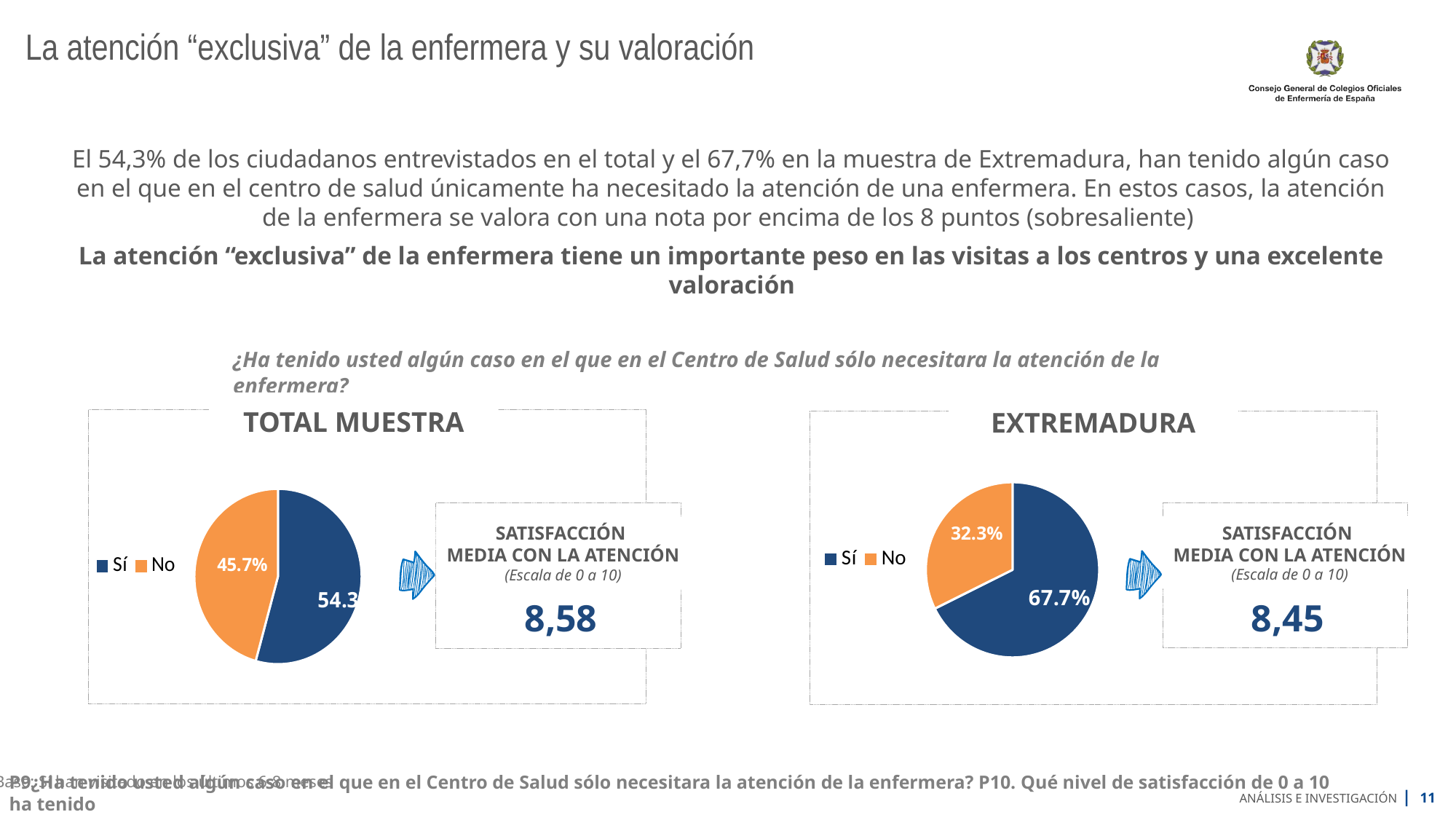
In the EXTREMADURA pie chart, what percentage is shown for No? 32.3% What type of chart is used under TOTAL MUESTRA? Pie chart Is the No share larger in the TOTAL MUESTRA pie chart or in the EXTREMADURA pie chart? TOTAL MUESTRA In the EXTREMADURA pie chart, which category has the largest slice? Sí In the TOTAL MUESTRA pie chart, is the value for Sí greater or less than 50%? greater In the TOTAL MUESTRA pie chart, what colour is the No slice? Orange In the TOTAL MUESTRA pie chart, what percentage is shown for No? 45.7% In the EXTREMADURA pie chart, which category has the smallest slice? No In the EXTREMADURA pie chart, what percentage is shown for Sí? 67.7% In the EXTREMADURA pie chart, what is the difference between the Sí and No percentages? 35.4% In the TOTAL MUESTRA pie chart, which slice is larger, Sí or No? Sí How many categories does the legend of the EXTREMADURA pie chart list? 2